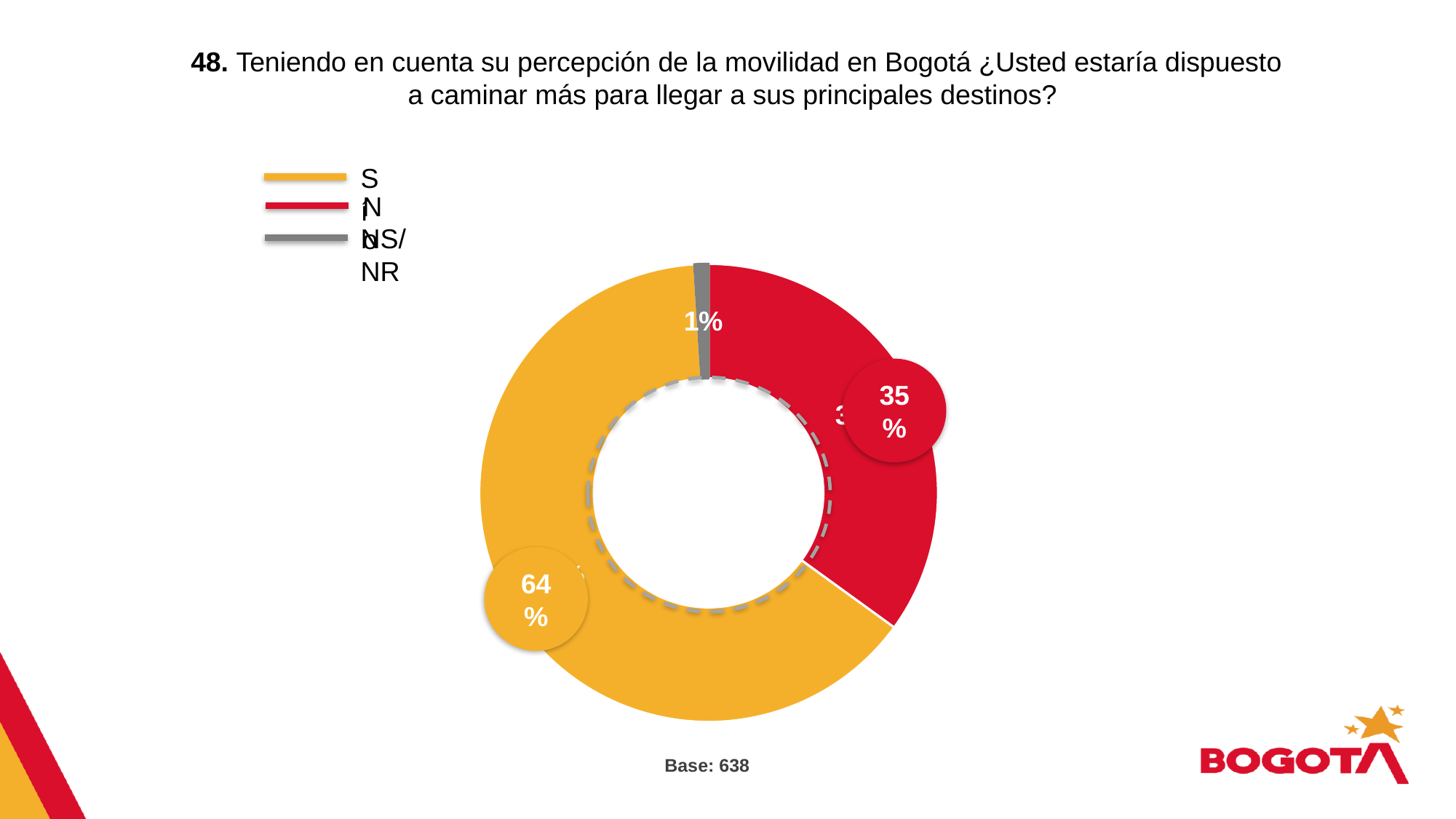
Which response has the smallest share of the chart? NS/NR (1%) What is the base (number of respondents) shown below the chart? 638 How many slices does the chart have? 3 Which response has the largest share of the chart? Sí (64%) What is the difference in percentage points between the Sí slice and the No slice? 29 percentage points What percentage is shown for the red slice (No)? 35% What percentage is shown for the yellow slice (Sí)? 64% What colour represents the NS/NR category in the chart? Gray Which is larger, the share for No or the share for NS/NR? No What kind of chart is shown on the slide? Pie chart (donut) What percentage is shown for the gray slice (NS/NR)? 1% How many entries does the legend list? 3